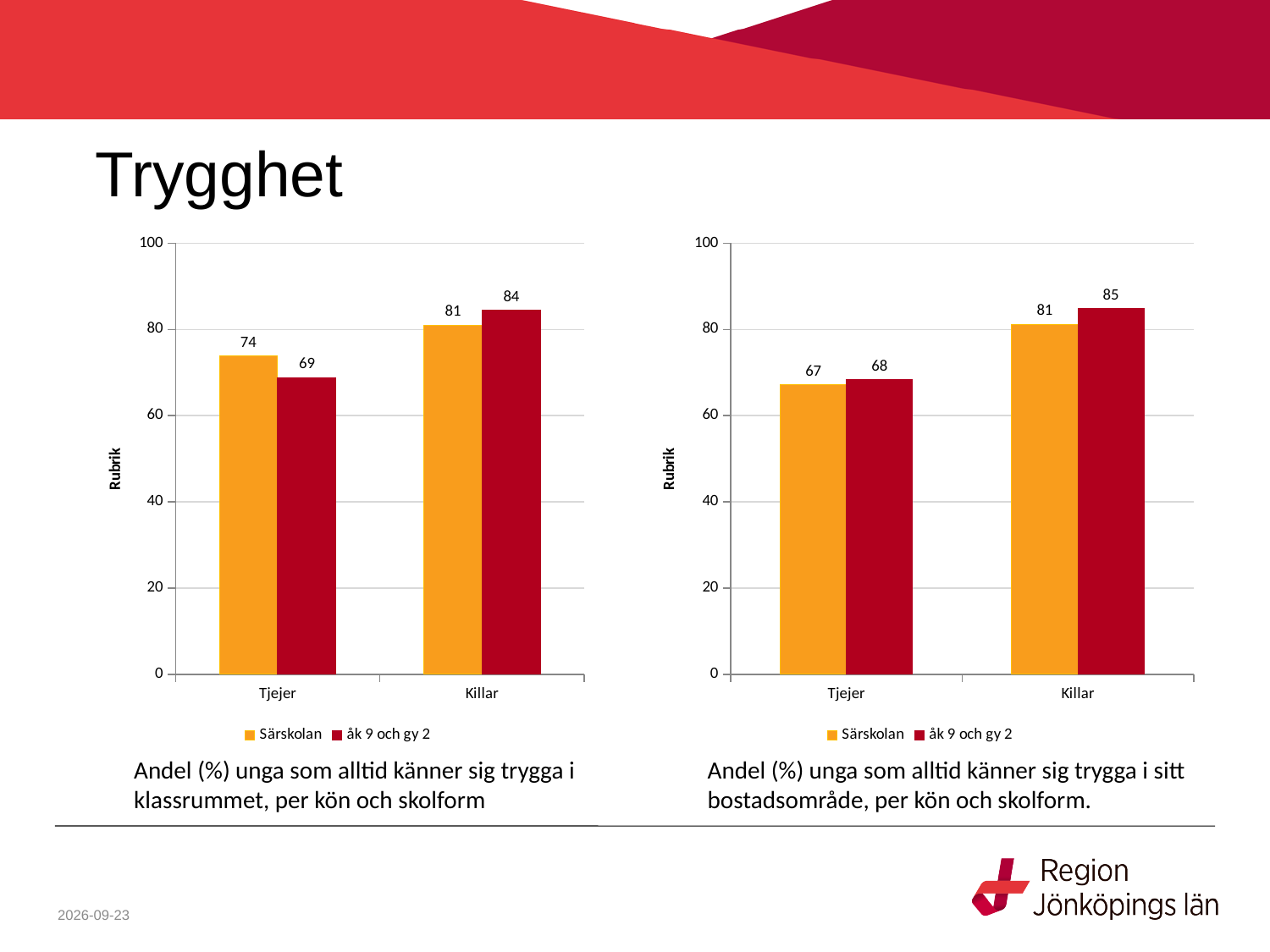
In the left chart (trygga i klassrummet), what is the value for Särskolan among Tjejer? 74 In the right chart (trygga i sitt bostadsområde), what is the label of the y axis? Rubrik In the left chart (trygga i klassrummet), what is the difference between Särskolan and åk 9 och gy 2 among Tjejer? 5 In the right chart (trygga i sitt bostadsområde), what is the difference between Killar and Tjejer for Särskolan? 14 What kind of chart is the left chart (trygga i klassrummet)? Bar chart In the right chart (trygga i sitt bostadsområde), which bar has the highest value? åk 9 och gy 2, Killar In the right chart (trygga i sitt bostadsområde), what is the value for åk 9 och gy 2 among Killar? 85 In the left chart (trygga i klassrummet), which bar has the lowest value? åk 9 och gy 2, Tjejer How many series does the legend of the right chart (trygga i sitt bostadsområde) list? 2 In the right chart (trygga i sitt bostadsområde), what is the value for Särskolan among Tjejer? 67 In the left chart (trygga i klassrummet), which is larger among Tjejer: Särskolan or åk 9 och gy 2? Särskolan In the left chart (trygga i klassrummet), what is the value for åk 9 och gy 2 among Killar? 84